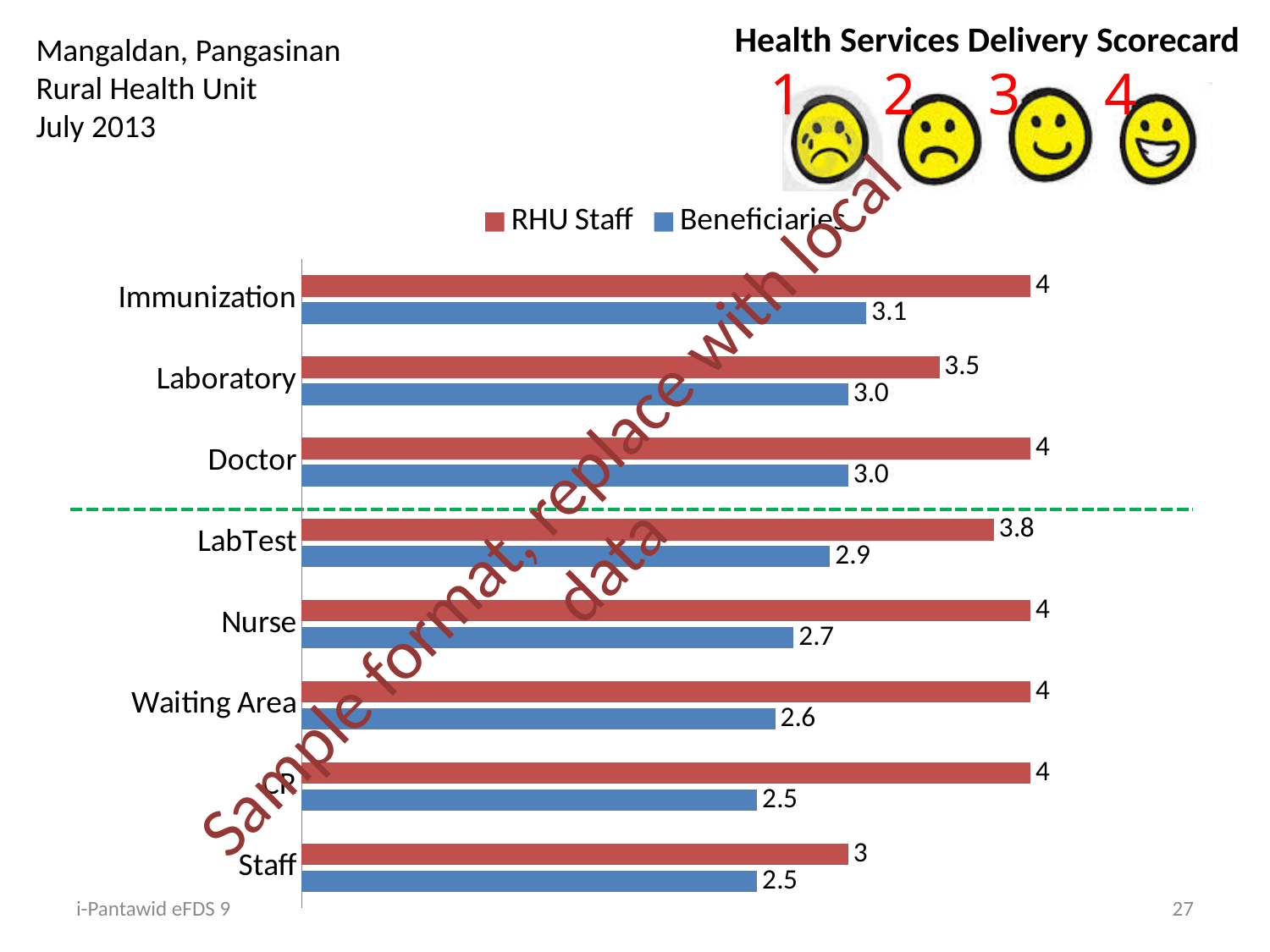
What kind of chart is shown on the slide? Bar chart How many series does the legend list? 2 Which category has the lowest RHU Staff value? Staff What is the difference between the RHU Staff and Beneficiaries values for Nurse? 1.3 Which category has the highest Beneficiaries value? Immunization What is the difference between the RHU Staff and Beneficiaries values for Immunization? 0.9 What colour are the RHU Staff bars? Red What is the RHU Staff value for LabTest? 3.8 What is the RHU Staff value for Immunization? 4 What is the Beneficiaries value for Nurse? 2.7 For Laboratory, which series has the larger value, RHU Staff or Beneficiaries? RHU Staff What is the Beneficiaries value for Laboratory? 3.0